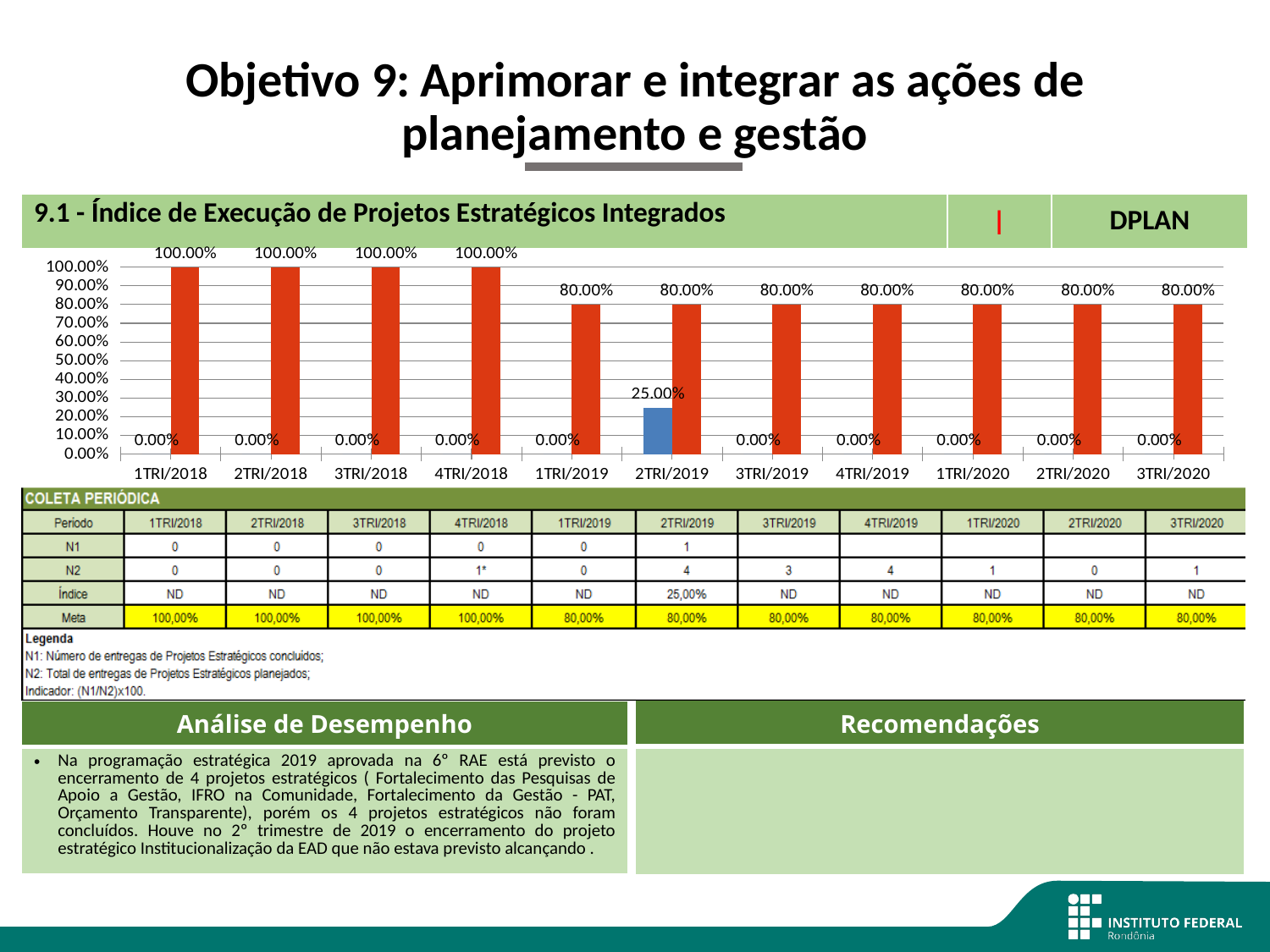
What type of chart is shown on the slide? bar chart What is the value of the red bar for 3TRI/2019? 80.00% Which is larger, the red bar for 2TRI/2018 or the red bar for 2TRI/2020? 2TRI/2018 What is the value of the blue bar for 2TRI/2019? 25.00% What is the difference between the red bar and the blue bar in 2TRI/2019? 55.00% In which period does the blue bar reach its highest value? 2TRI/2019 Is the blue bar for 2TRI/2019 greater or less than 30.00%? less What is the value of the red bar for 1TRI/2018? 100.00% Do the red bar values rise or fall from 4TRI/2018 to 1TRI/2019? fall How many periods (categories) are shown on the x axis of the chart? 11 What is the value of the blue bar for 1TRI/2020? 0.00% What is the difference between the red bar value for 4TRI/2018 and the red bar value for 1TRI/2019? 20.00%